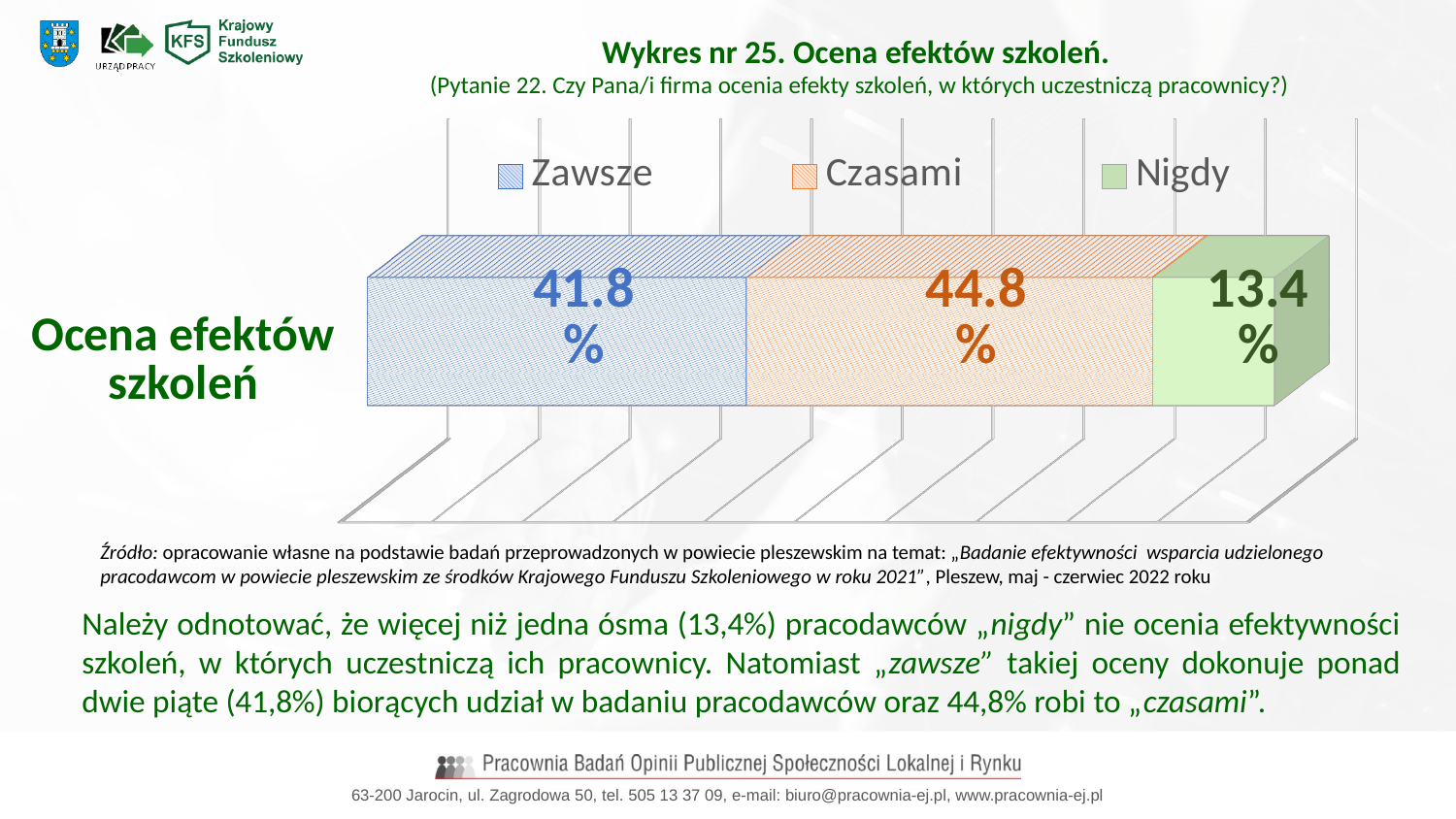
What is the difference between the "Zawsze" and "Nigdy" values? 28.4% What is the value for the "Nigdy" series in the chart? 13.4% Which series has the lowest value in the chart? Nigdy What is the difference between the "Czasami" and "Zawsze" values? 3.0% How many series does the legend list? 3 What is the title of the chart? Wykres nr 25. Ocena efektów szkoleń. What kind of chart is shown on the slide? Stacked bar chart What is the value for the "Zawsze" series in the chart? 41.8% Which series has the highest value in the chart? Czasami Which is larger, the value for "Zawsze" or the value for "Nigdy"? Zawsze What is the total of the stacked bar for "Ocena efektów szkoleń"? 100% What is the value for the "Czasami" series in the chart? 44.8%